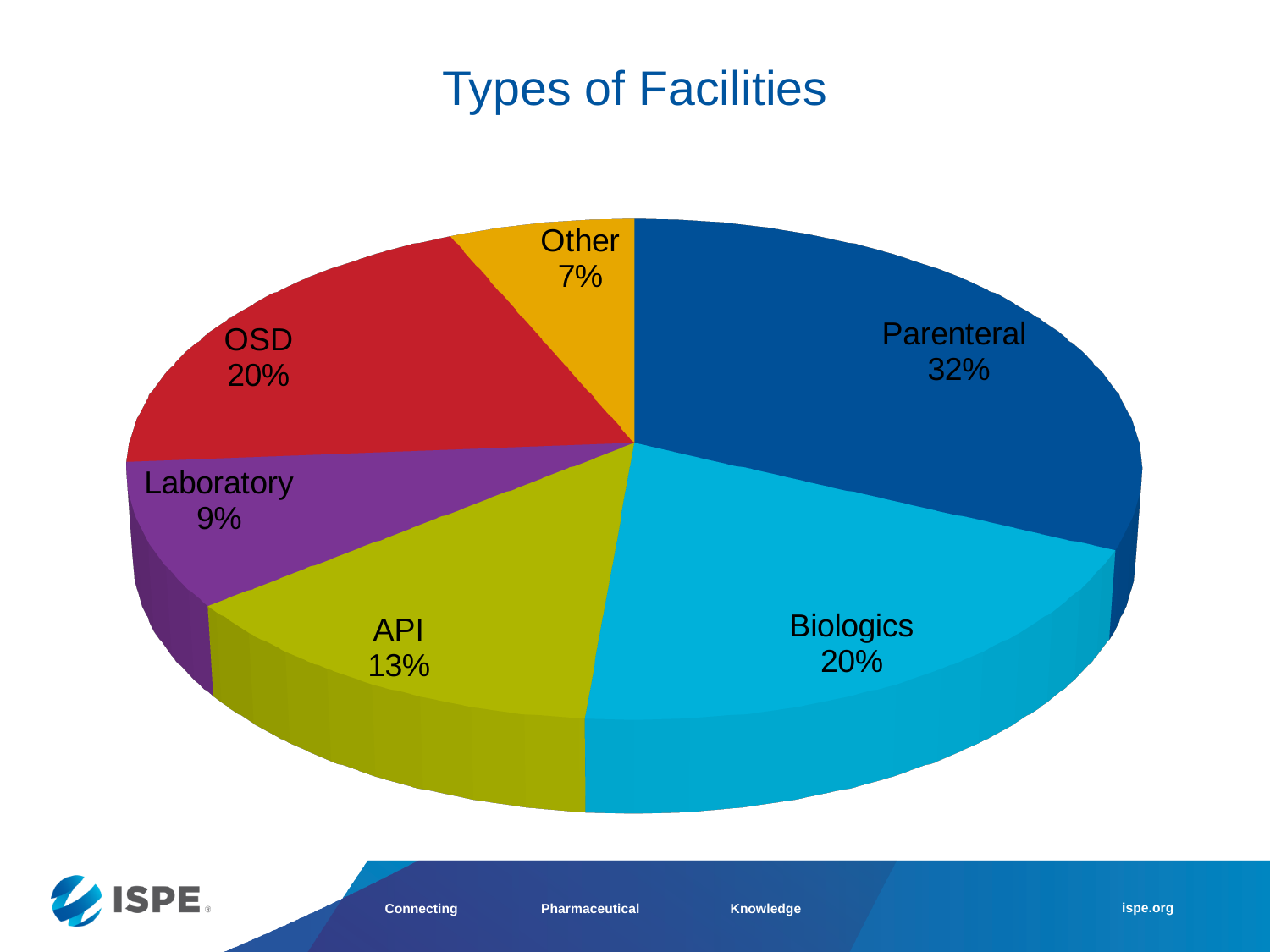
What is the title of the chart? Types of Facilities What share of the pie does Parenteral represent? 32% Which type of facility has the largest share? Parenteral What is the value shown for OSD? 20% What kind of chart is shown on the slide? Pie chart Which is larger, the share for API or the share for Laboratory? API What is the difference in percentage points between Parenteral and Biologics? 12 What is the difference in percentage points between OSD and Other? 13 What is the value shown for API? 13% How many categories are shown in the pie chart? 6 Which type of facility has the smallest share? Other What is the value shown for Laboratory? 9%